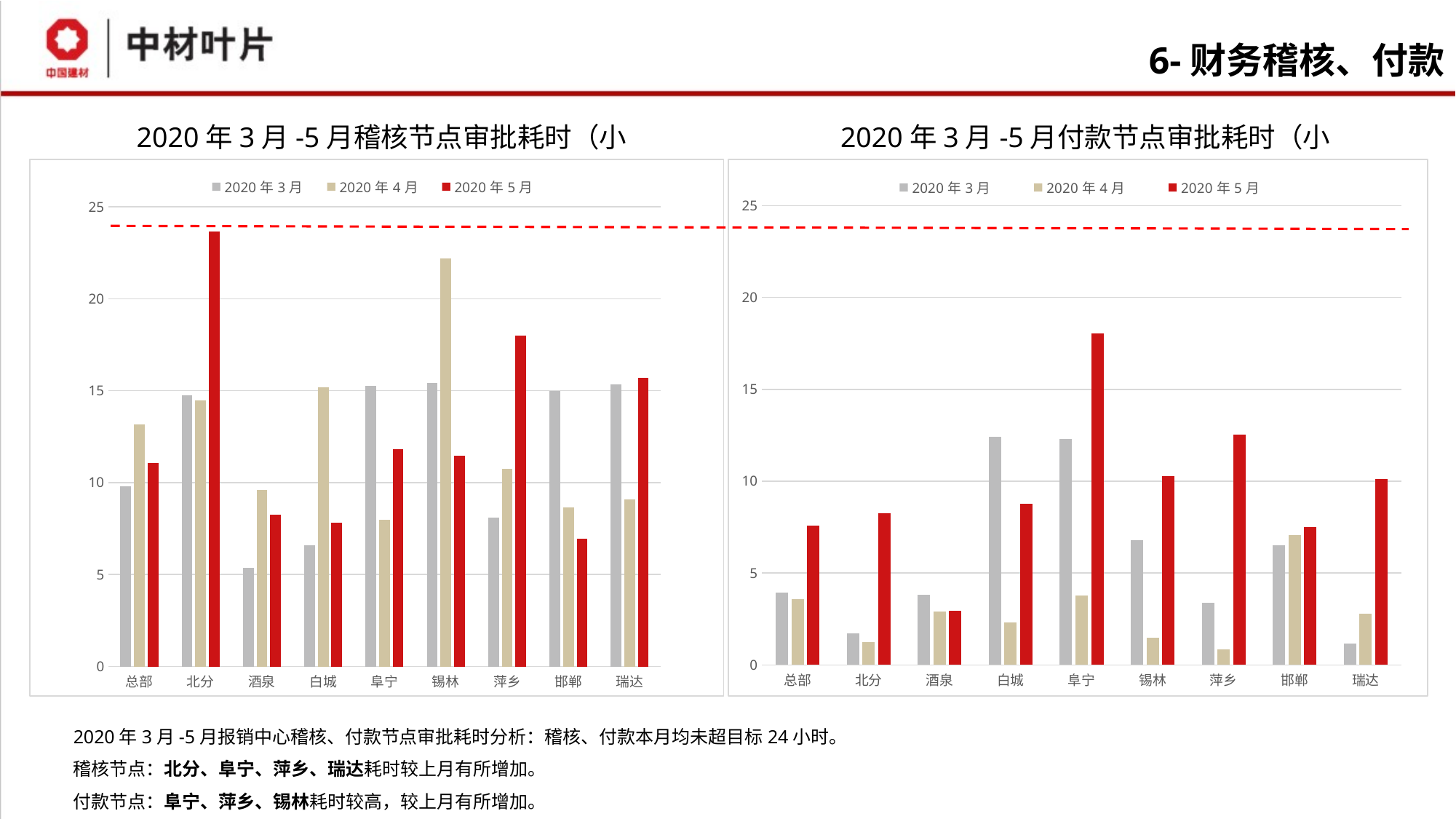
In the left chart (2020年3月-5月稽核节点审批耗时), is the 2020年5月 value for 北分 greater or less than 20? greater In the right chart (2020年3月-5月付款节点审批耗时), which category has the lowest 2020年5月 value? 酒泉 In the right chart (2020年3月-5月付款节点审批耗时), is the 2020年5月 value for 阜宁 greater or less than 15? greater What kind of chart is the left chart (2020年3月-5月稽核节点审批耗时)? bar chart In the left chart (2020年3月-5月稽核节点审批耗时), which category has the highest 2020年5月 value? 北分 In the right chart (2020年3月-5月付款节点审批耗时), is the 2020年4月 value for 萍乡 greater or less than 5? less In the right chart (2020年3月-5月付款节点审批耗时), for 白城, which is larger: the 2020年3月 value or the 2020年5月 value? 2020年3月 How many series does the legend of the right chart (2020年3月-5月付款节点审批耗时) list? 3 In the right chart (2020年3月-5月付款节点审批耗时), which category has the highest 2020年5月 value? 阜宁 How many categories are shown on the x axis of the left chart (2020年3月-5月稽核节点审批耗时)? 9